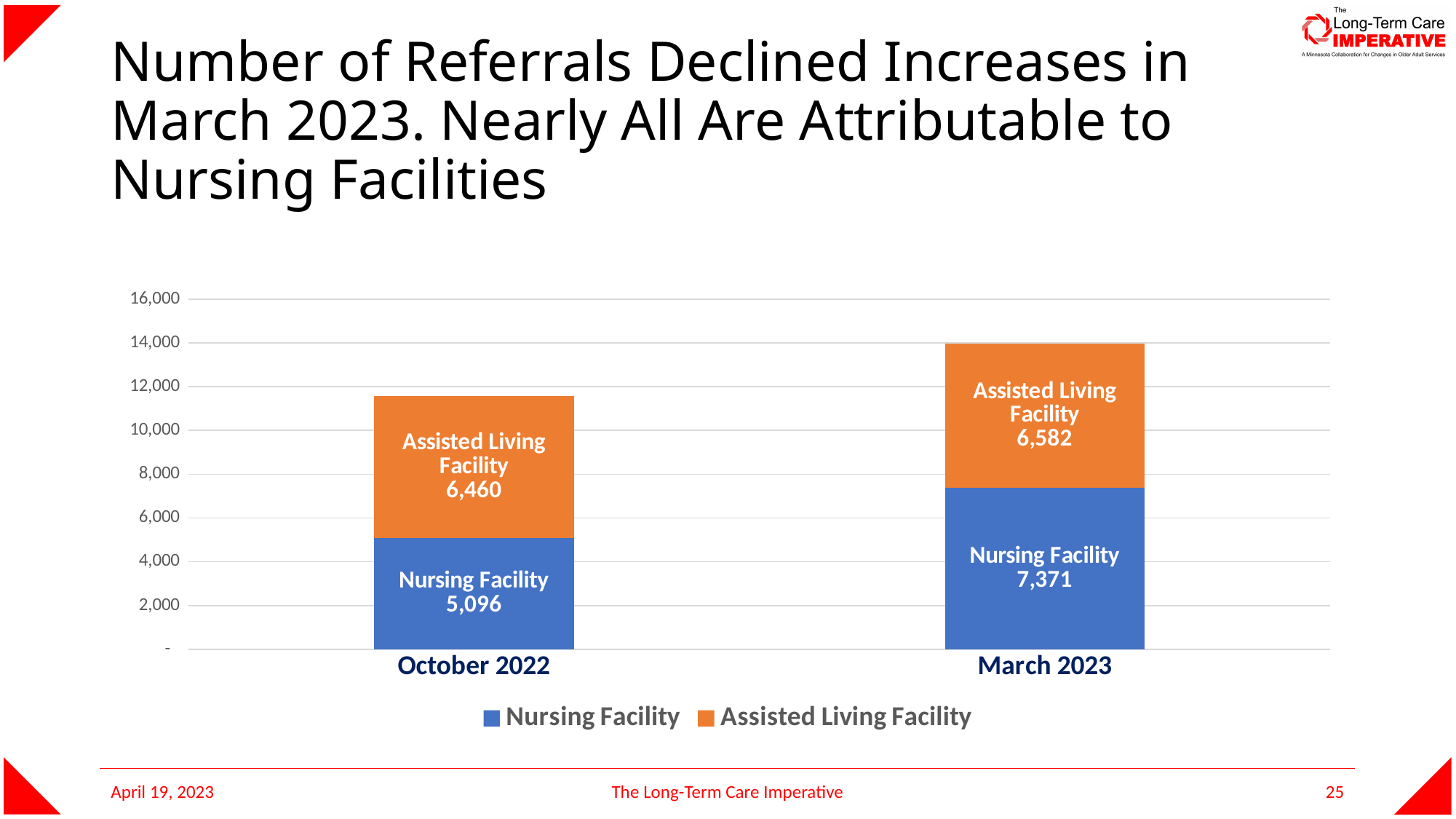
What is the total of the stacked bar for October 2022? 11,556 What is the Assisted Living Facility value for March 2023? 6,582 What is the Nursing Facility value for March 2023? 7,371 Which colour represents the Assisted Living Facility series? Orange What is the Assisted Living Facility value for October 2022? 6,460 What is the difference between the Assisted Living Facility values for March 2023 and October 2022? 122 What is the Nursing Facility value for October 2022? 5,096 How many series does the legend list? 2 What kind of chart is shown on the slide? Stacked bar chart By how much did the Nursing Facility value increase from October 2022 to March 2023? 2,275 Which period has the larger Nursing Facility value, October 2022 or March 2023? March 2023 What is the total of the stacked bar for March 2023? 13,953